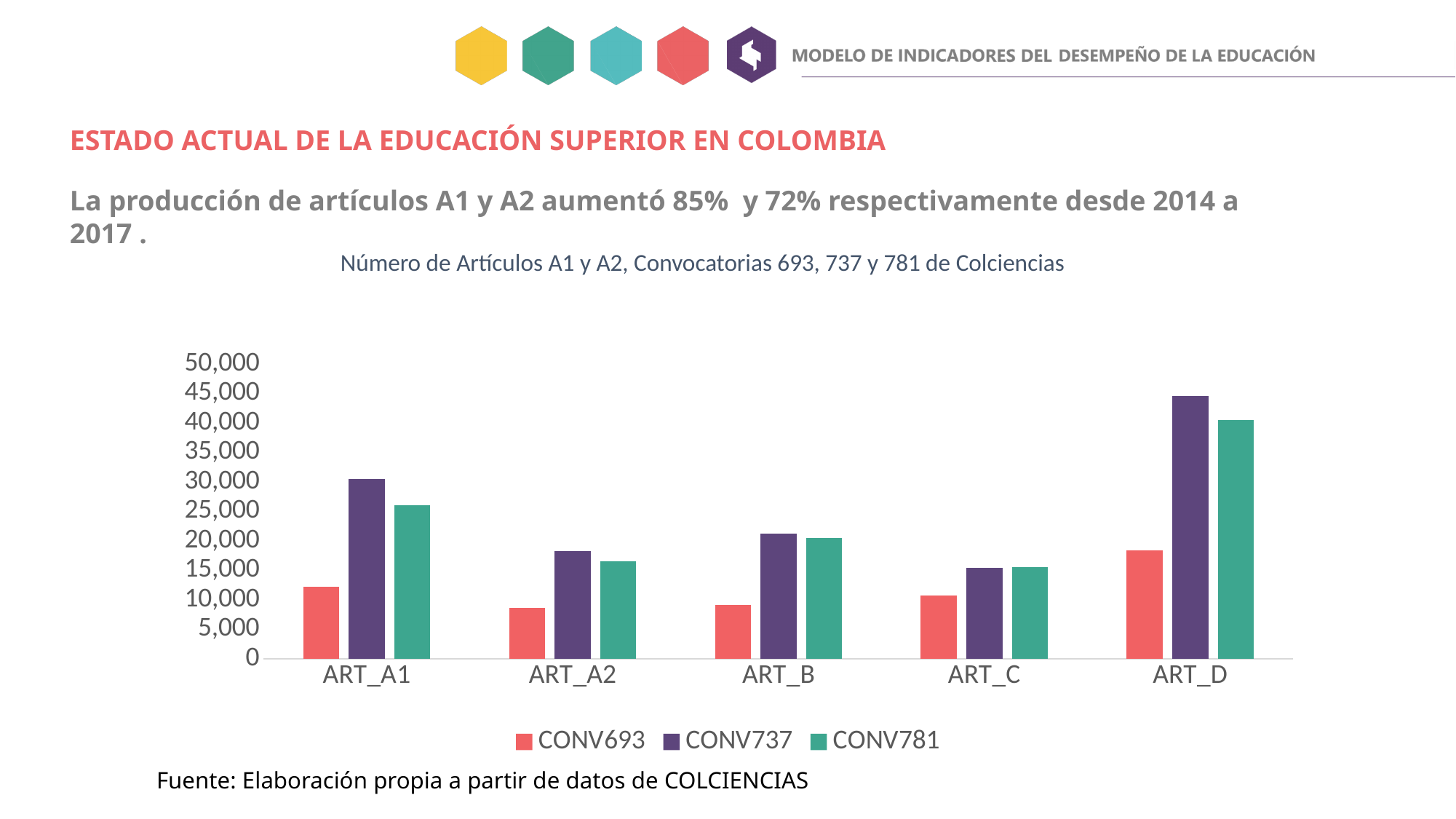
Is the CONV737 value for ART_D greater or less than 40,000? greater What kind of chart is shown on the slide? bar chart Is the CONV781 value for ART_B greater or less than 15,000? greater Which category has the highest CONV737 bar? ART_D How many categories are shown on the x axis? 5 Which is larger: the CONV781 value for ART_D or the CONV737 value for ART_A1? CONV781 for ART_D Which category has the lowest CONV693 bar? ART_A2 For ART_A1, which series has the larger value, CONV737 or CONV781? CONV737 What is the title of the chart? Número de Artículos A1 y A2, Convocatorias 693, 737 y 781 de Colciencias What are the three series listed in the legend? CONV693, CONV737, CONV781 Is the CONV693 value for ART_A1 greater or less than 15,000? less How many series does the legend list? 3